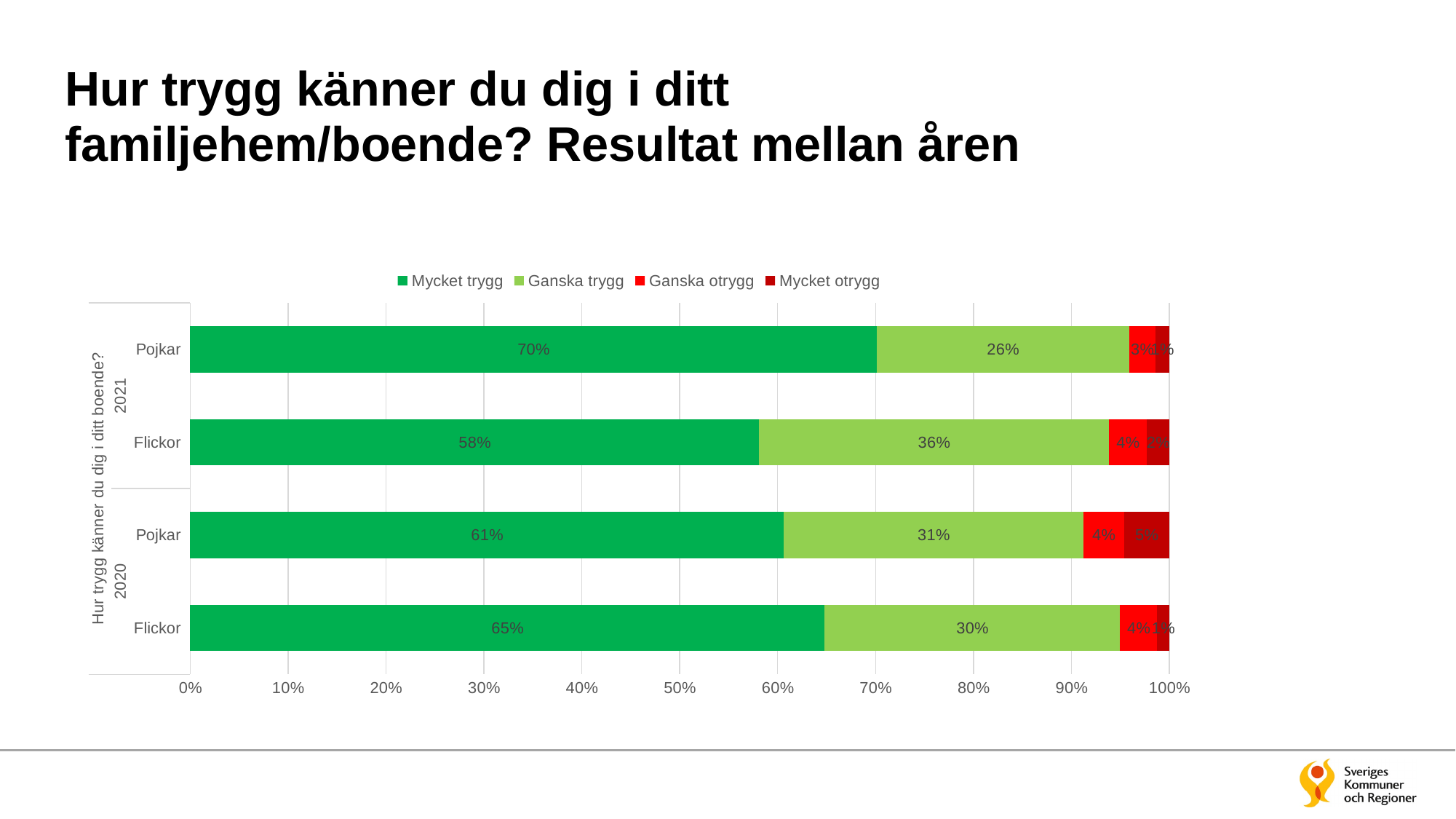
What share of Pojkar in 2021 answered Mycket trygg? 70% What share of Flickor in 2020 answered Ganska trygg? 30% How many series does the legend list? 4 Which group has the highest share of Mycket trygg? Pojkar 2021 Which is larger: the Ganska trygg share for Pojkar 2020 or for Flickor 2020? Pojkar 2020 What share of Flickor in 2021 answered Ganska otrygg? 4% What share of Pojkar in 2020 answered Mycket trygg? 61% Which group has the lowest share of Mycket trygg? Flickor 2021 What is the difference in the Mycket trygg share between Pojkar 2021 and Flickor 2021? 12 percentage points What kind of chart is shown on the slide? Stacked bar chart What share of Flickor in 2021 answered Ganska trygg? 36% How many bars are shown in the chart? 4